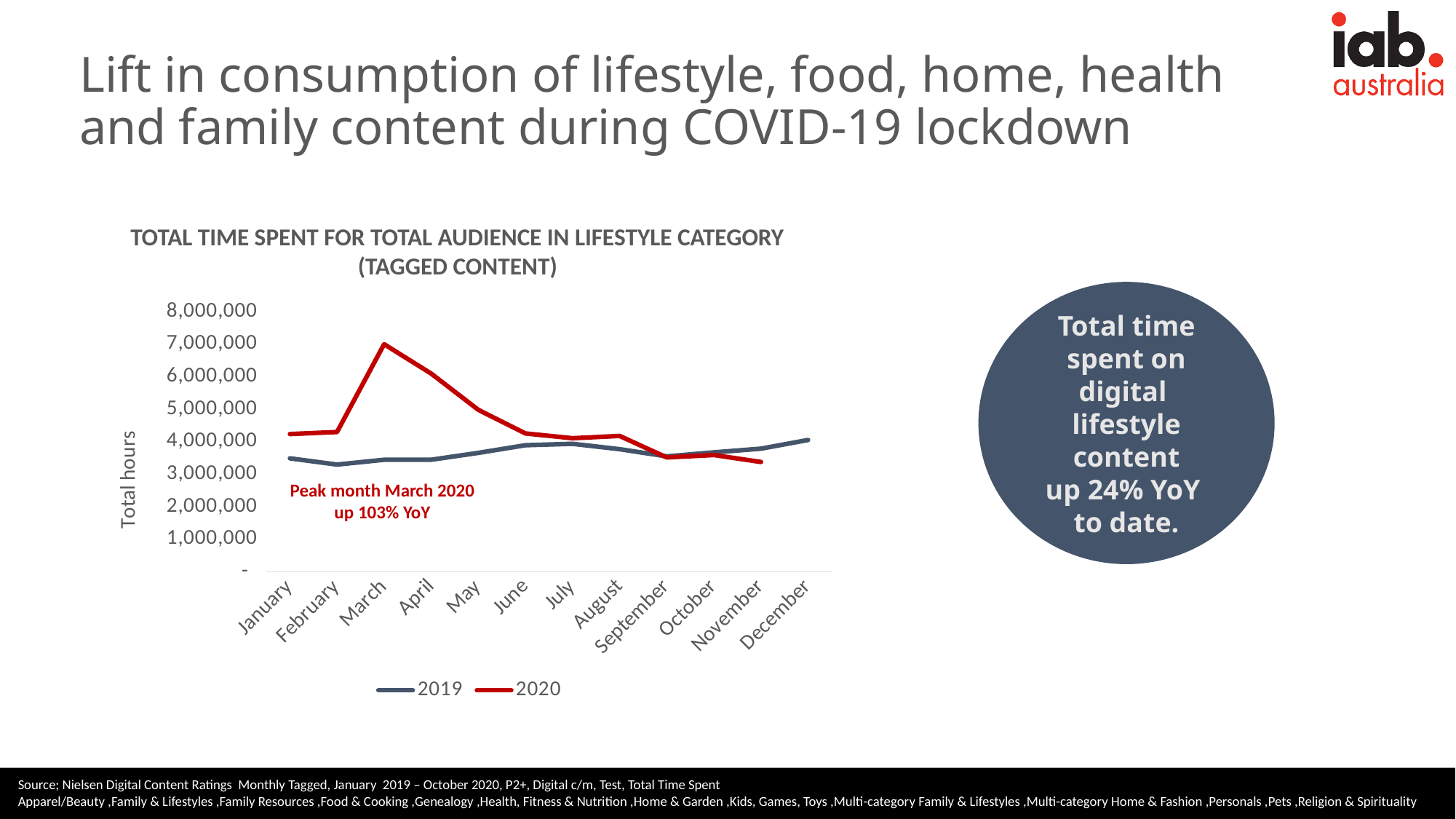
In which month does the 2020 series reach its highest value? March Is the 2019 value for December greater or less than 3,000,000? greater Does the 2020 series rise or fall from March to September? fall Which series has the larger value in March, 2019 or 2020? 2020 How many months are shown along the x axis of the chart? 12 What kind of chart is shown on the slide? Line chart Is the 2020 value for January greater or less than 4,000,000? greater Is the 2020 value for March greater or less than 6,000,000? greater How many series does the chart legend list? 2 What colour is the line for the 2020 series? Red Which series has the larger value in November, 2019 or 2020? 2019